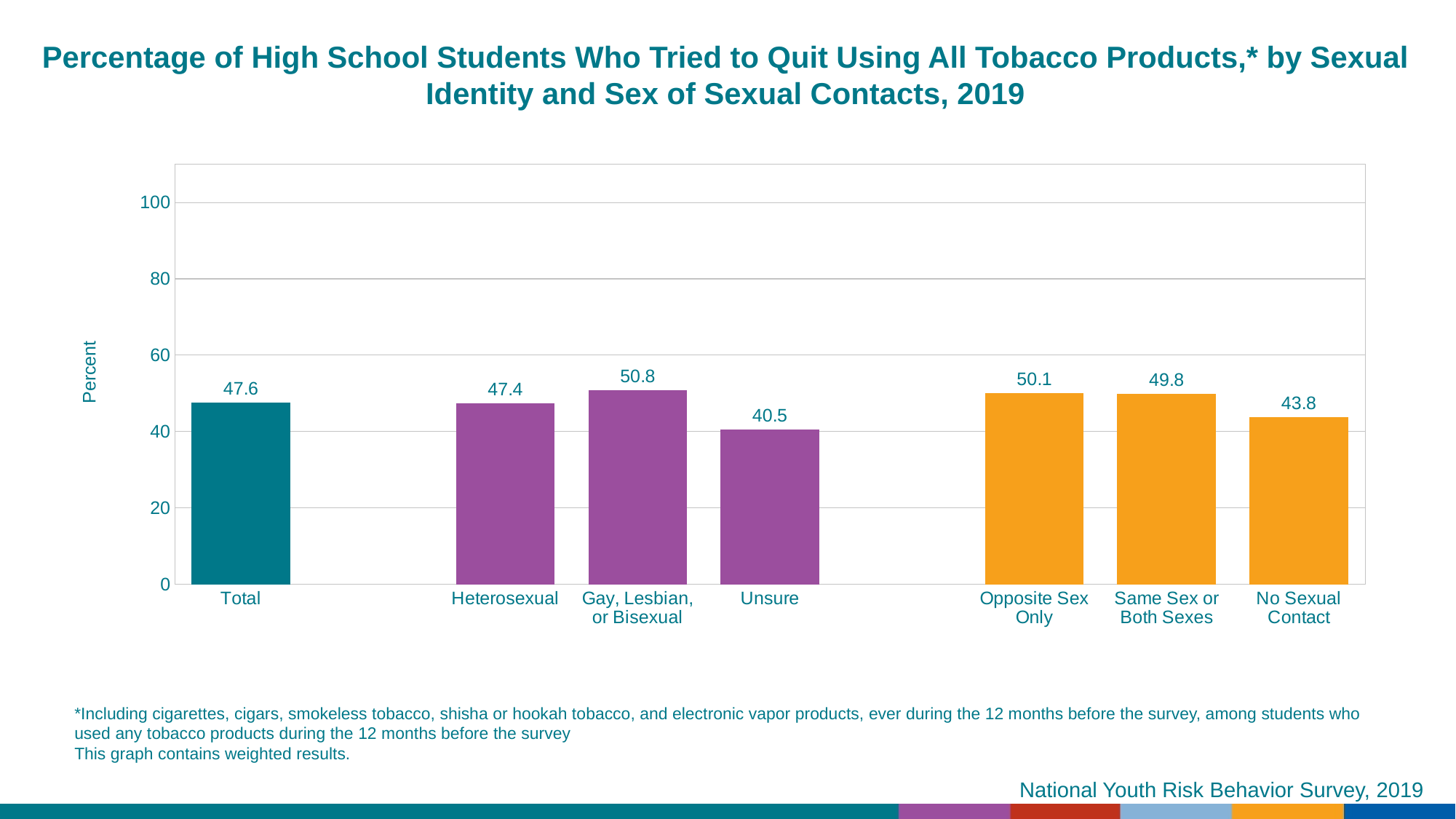
What is the label of the y axis? Percent What kind of chart is shown on the slide? bar chart Which category has the highest value? Gay, Lesbian, or Bisexual Is the value for No Sexual Contact greater or less than 40? greater Which is larger, the value for Heterosexual or the value for Unsure? Heterosexual What percentage of Unsure students tried to quit using all tobacco products? 40.5 What is the value for Same Sex or Both Sexes? 49.8 What is the difference between the values for Opposite Sex Only and No Sexual Contact? 6.3 Which category has the lowest value? Unsure What is the difference between the values for Gay, Lesbian, or Bisexual and Heterosexual? 3.4 How many categories are shown on the x axis? 7 What is the value for Total? 47.6